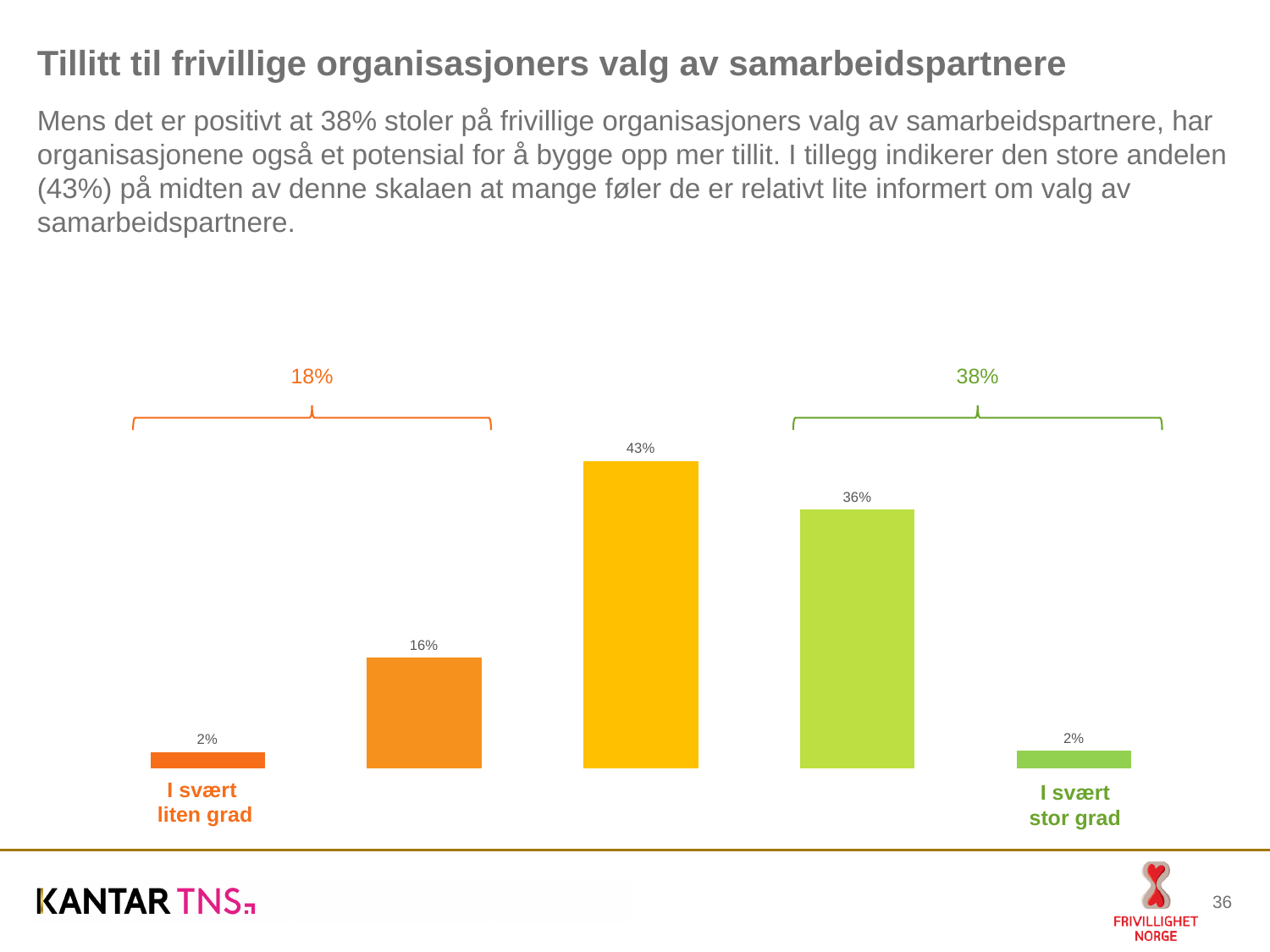
What colour is the tallest bar in the chart? yellow What is the value of the fourth bar from the left? 36% Which is larger: the second bar from the left or the fourth bar from the left? the fourth bar (36%) What is the value of the bar labelled "I svært liten grad"? 2% What combined percentage is shown by the green bracket over the two rightmost bars? 38% What is the difference between the middle bar (43%) and the fourth bar (36%)? 7% What is the value of the second bar from the left? 16% What kind of chart is shown on the slide? bar chart What is the value of the tallest bar in the chart? 43% What is the value of the bar labelled "I svært stor grad"? 2% How many bars are plotted in the chart? 5 What combined percentage is shown by the orange bracket over the two leftmost bars? 18%